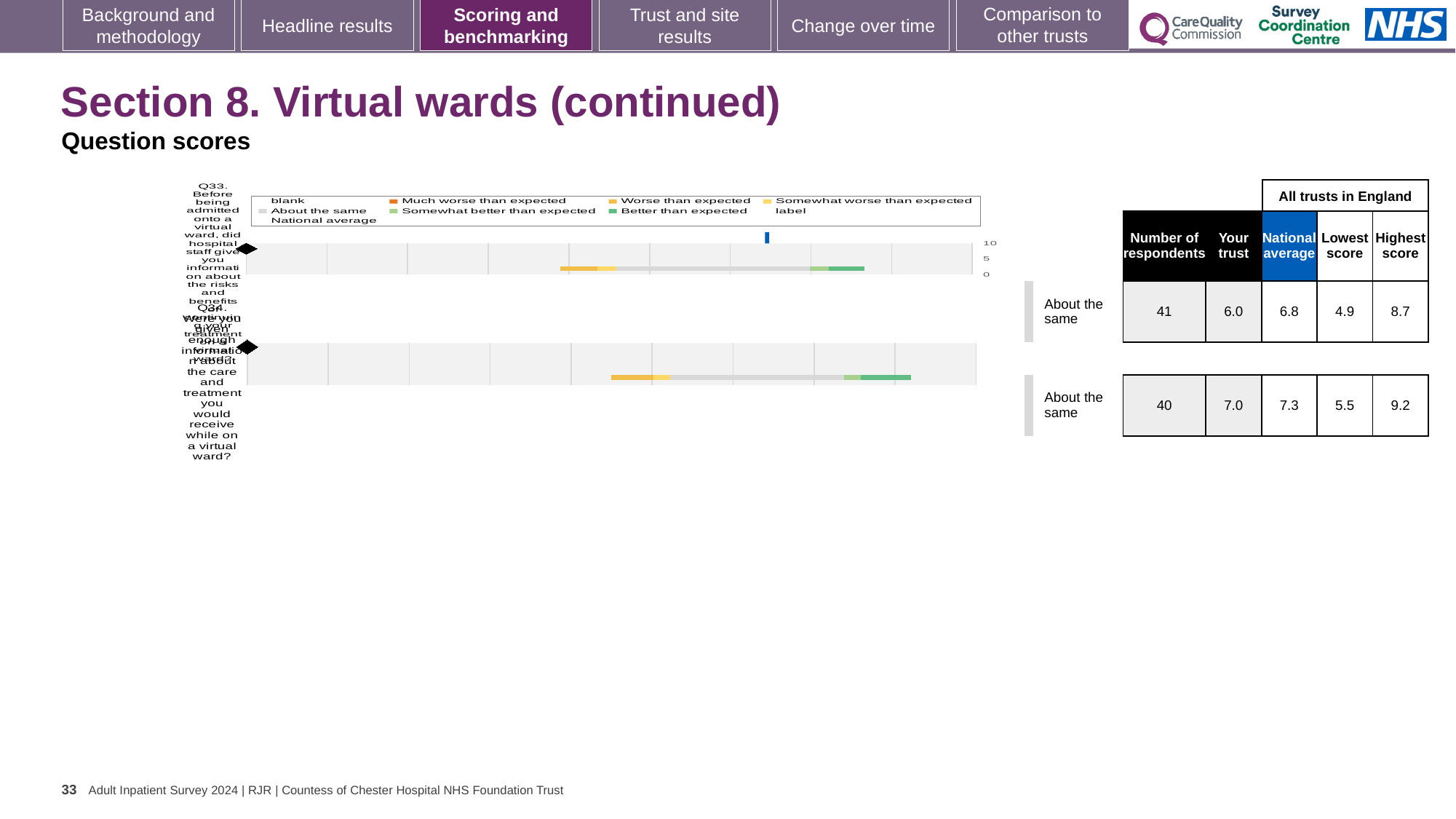
For Q33, what is the difference between the highest and lowest scores among all trusts in England? 3.8 Which benchmark category is shown for Q33? About the same Which question has the higher 'Your trust' score, Q33 or Q34? Q34 What colour represents 'Better than expected' in the chart legend? Green For Q34, what is the difference between the national average and the 'Your trust' score? 0.3 What is the lowest score among all trusts in England for Q33? 4.9 How many questions are plotted on the slide? 2 What is the highest score among all trusts in England for Q34? 9.2 What is the national average score for Q34 (enough information about care and treatment on a virtual ward)? 7.3 How many respondents answered Q33? 41 What is the 'Your trust' score for Q33 (information about the risks and benefits of a virtual ward)? 6.0 What kind of chart is used to show the question scores? Bar chart